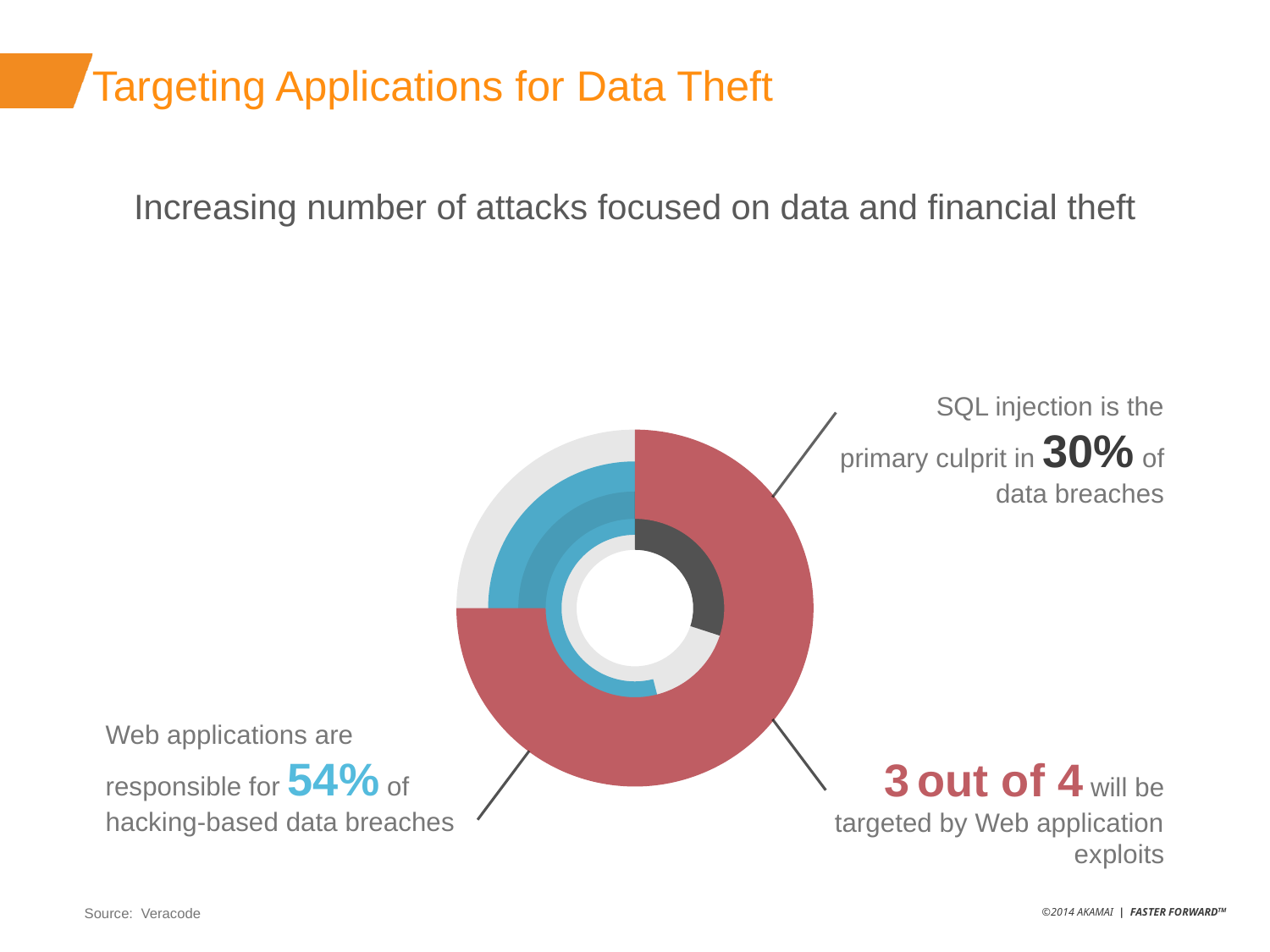
Which is larger: the share of hacking-based data breaches attributed to Web applications or the share of data breaches where SQL injection is the primary culprit? Web applications (54%) How many out of 4 will be targeted by Web application exploits, according to the chart? 3 out of 4 What kind of chart is shown on the slide? donut chart SQL injection is the primary culprit in what percentage of data breaches, according to the chart? 30% How many statistics are annotated around the donut chart? 3 According to the chart, what percentage of hacking-based data breaches are Web applications responsible for? 54% Which of the three annotated statistics on the chart is the smallest? SQL injection is the primary culprit in 30% of data breaches What is the difference in percentage points between the Web applications figure (54%) and the SQL injection figure (30%)? 24 percentage points What colour is the ring of the chart that represents the 54% Web applications statistic? blue What source is cited for the chart on the slide? Veracode Which of the three annotated statistics on the chart is the largest? 3 out of 4 will be targeted by Web application exploits